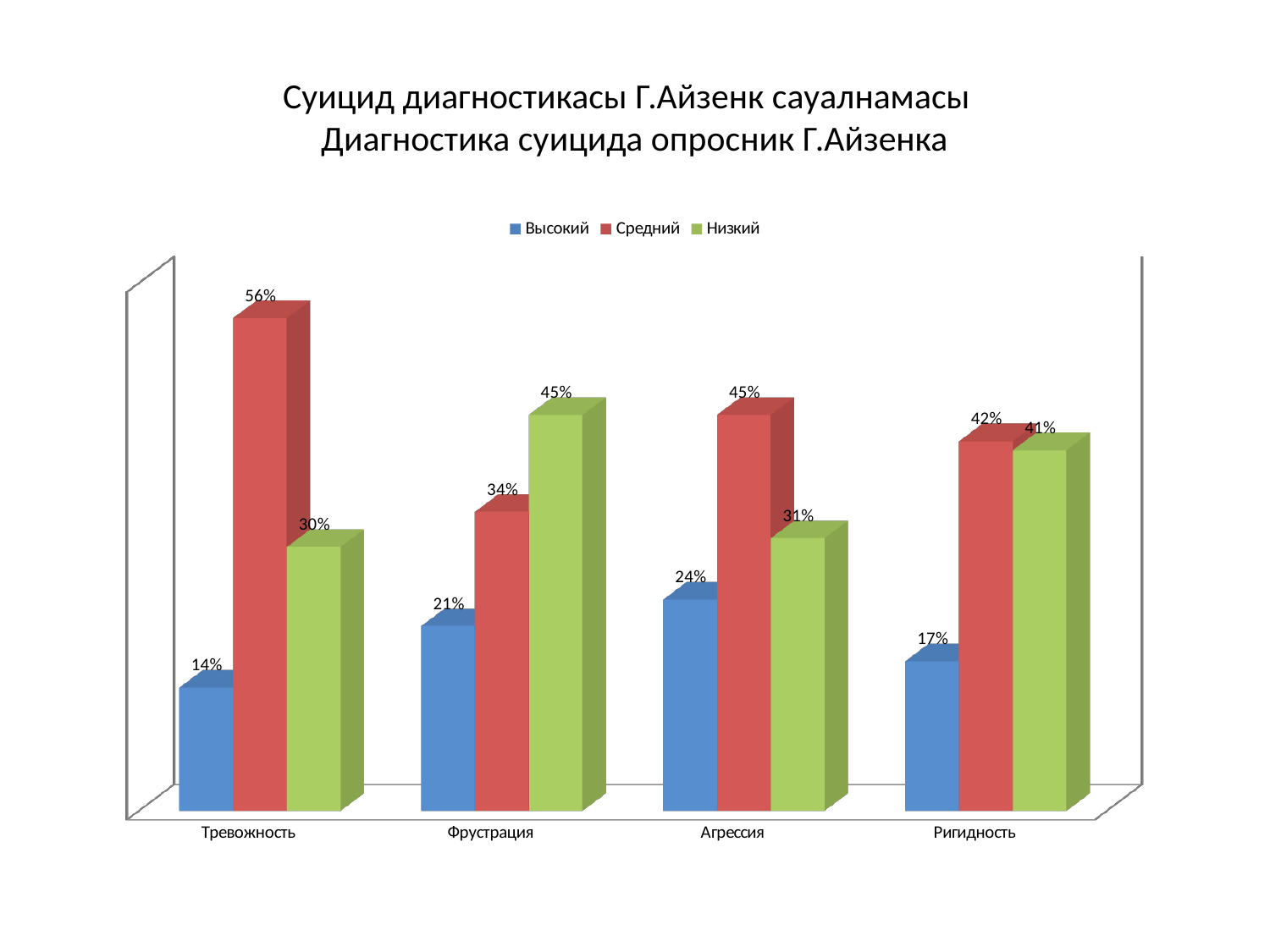
How many series does the legend list? 3 Which category has the highest value for the Средний series? Тревожность What is the difference between the Средний and Высокий values in the Тревожность category? 42% How many categories are shown on the x axis? 4 Which category has the lowest value for the Высокий series? Тревожность What is the value for Низкий in the Ригидность category? 41% Which series is shown in red in the legend? Средний What kind of chart is shown on the slide? Bar chart What is the value for Низкий in the Фрустрация category? 45% What is the value for Высокий in the Агрессия category? 24% Which is larger in the Фрустрация category: Средний or Низкий? Низкий What is the value for Средний in the Тревожность category? 56%